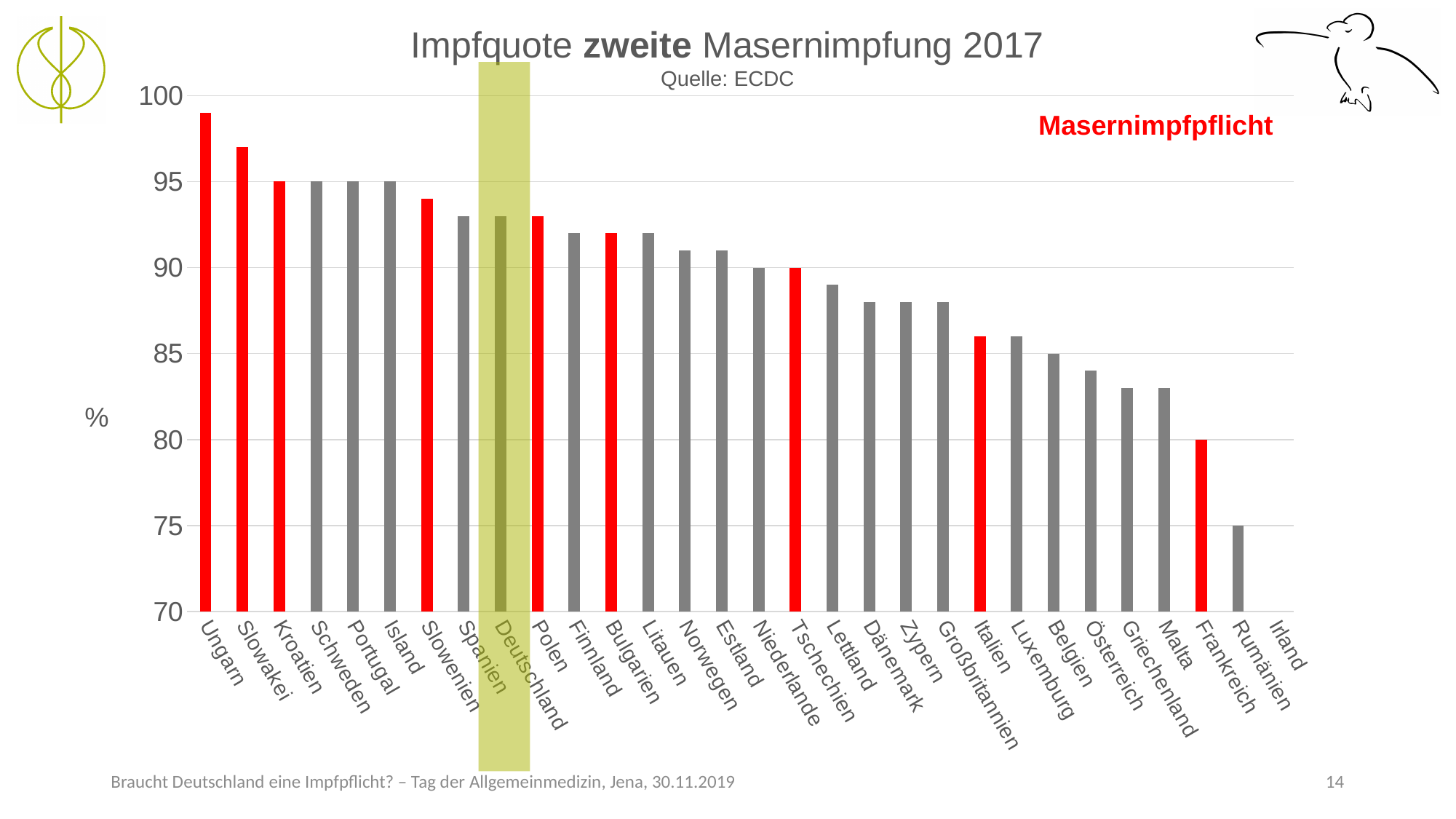
What is the value for Frankreich? 80 What is the difference between the values for Frankreich and Rumänien? 5 Do the values generally rise or fall from left to right along the x axis? fall Which has the larger value, Deutschland or Frankreich? Deutschland Which country is highlighted with the yellow vertical band? Deutschland What is the value for Schweden? 95 What is the value for Rumänien? 75 What is the title of the chart? Impfquote zweite Masernimpfung 2017 Which country has the tallest bar in the chart? Ungarn Is the value for Griechenland greater or less than 85? less Is the value for Deutschland greater or less than 95? less What kind of chart is shown on the slide? bar chart